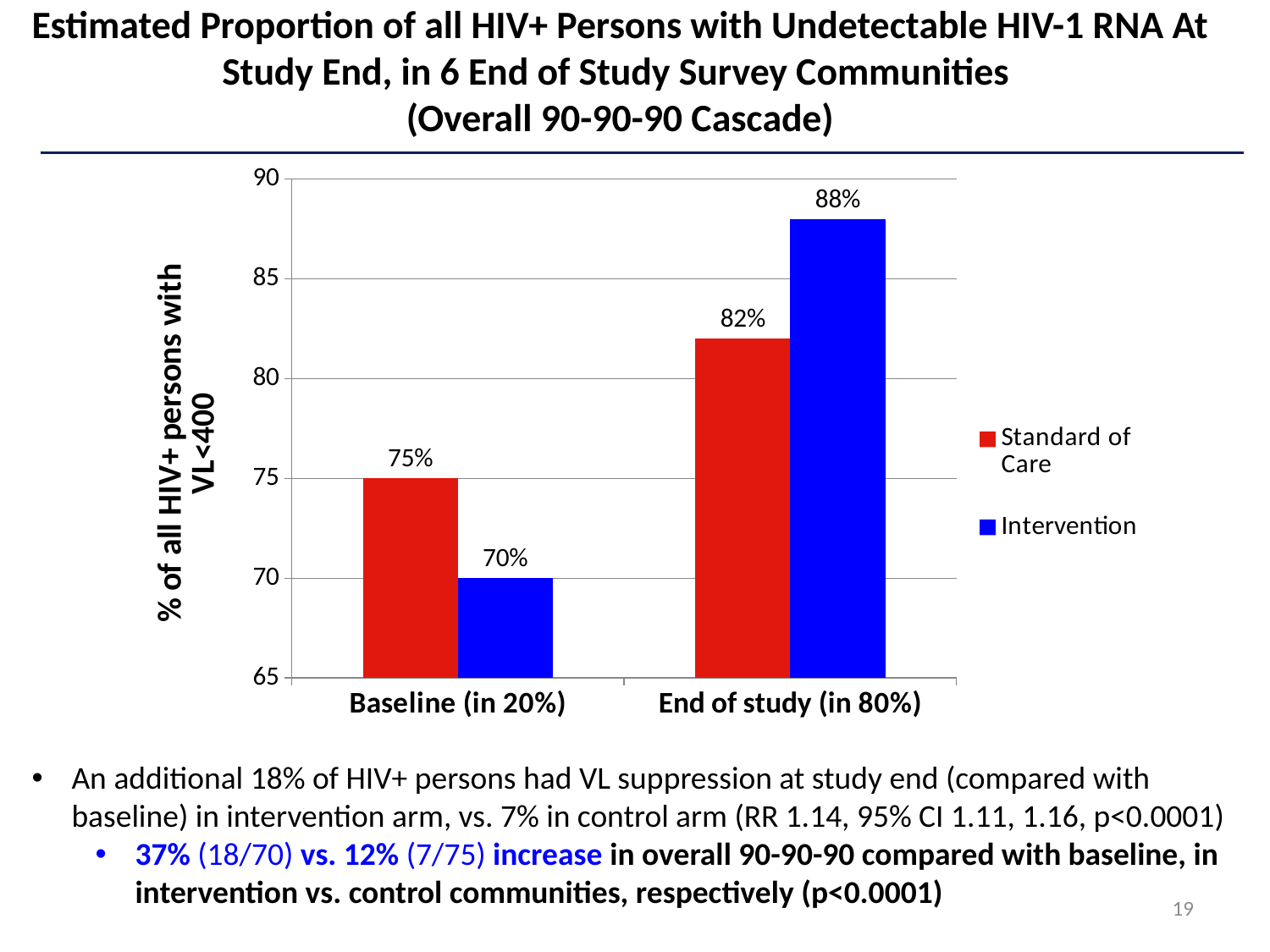
How many series does the legend list? 2 What kind of chart is shown on the slide? Bar chart What is the difference between the Intervention values at End of study (in 80%) and Baseline (in 20%)? 18% What is the difference between the Intervention and Standard of Care values at End of study (in 80%)? 6% What is the Intervention value at End of study (in 80%)? 88% What is the Standard of Care value at Baseline (in 20%)? 75% What colour represents the Intervention series? Blue Which bar has the lowest value on the chart? Intervention at Baseline (in 20%) At Baseline (in 20%), which is larger: Standard of Care or Intervention? Standard of Care What is the Intervention value at Baseline (in 20%)? 70% What is the Standard of Care value at End of study (in 80%)? 82% Which bar has the highest value on the chart? Intervention at End of study (in 80%)